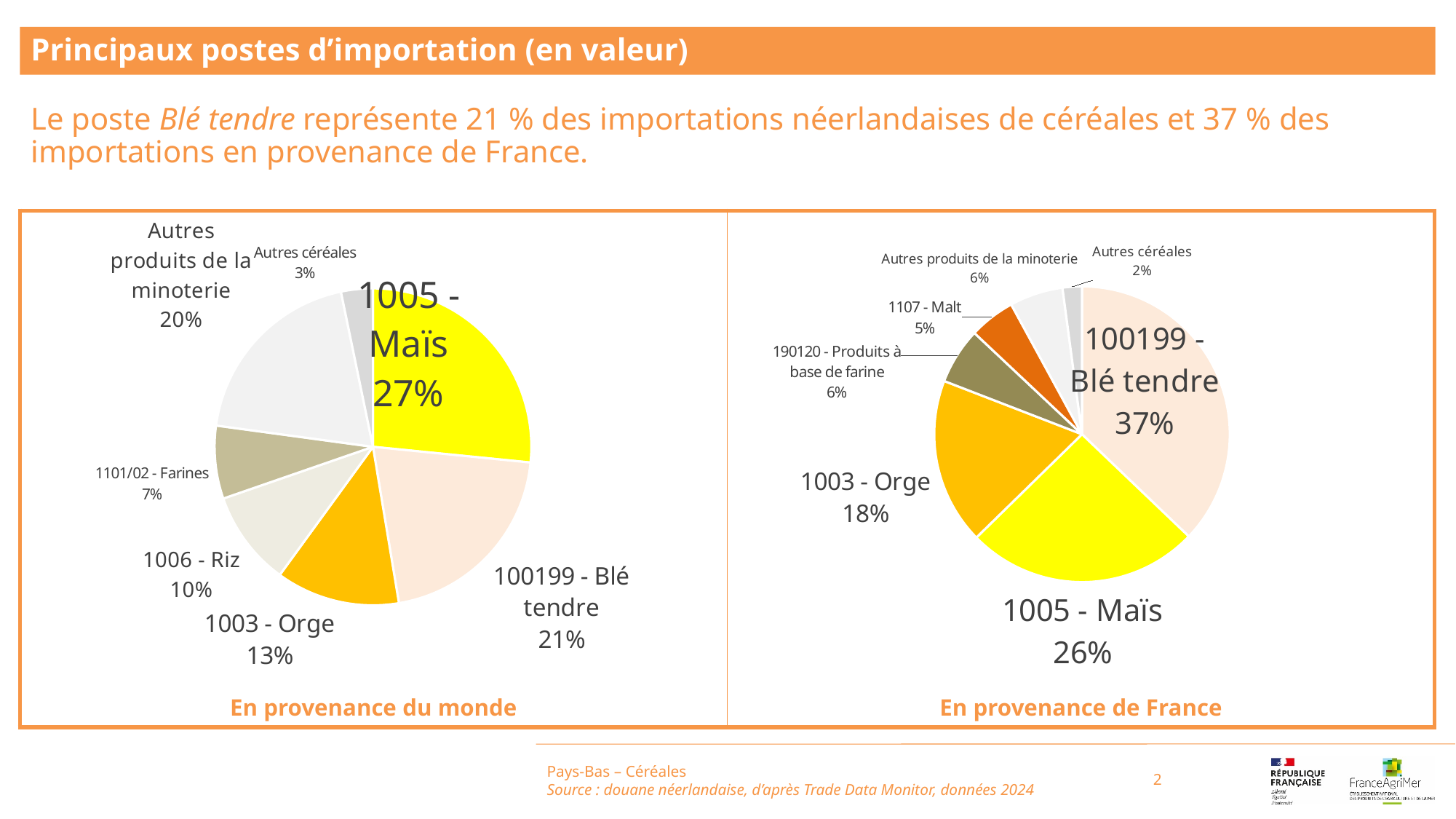
In the 'En provenance du monde' pie chart, what is the difference in percentage points between 1005 - Maïs and 100199 - Blé tendre? 6 percentage points In the 'En provenance de France' pie chart, which is larger: 1003 - Orge or 1005 - Maïs? 1005 - Maïs In the 'En provenance de France' pie chart, what share does 100199 - Blé tendre have? 37% In the 'En provenance du monde' pie chart, which category has the smallest share? Autres céréales In the 'En provenance de France' pie chart, which category has the largest share? 100199 - Blé tendre In the 'En provenance de France' pie chart, what is the difference in percentage points between 100199 - Blé tendre and 1005 - Maïs? 11 percentage points In the 'En provenance de France' pie chart, what share does 1107 - Malt have? 5% In the 'En provenance du monde' pie chart, which category has the largest share? 1005 - Maïs In the 'En provenance du monde' pie chart, what share does 1005 - Maïs have? 27% What type of chart is used on this slide? Pie chart In the 'En provenance du monde' pie chart, how many slices are there? 7